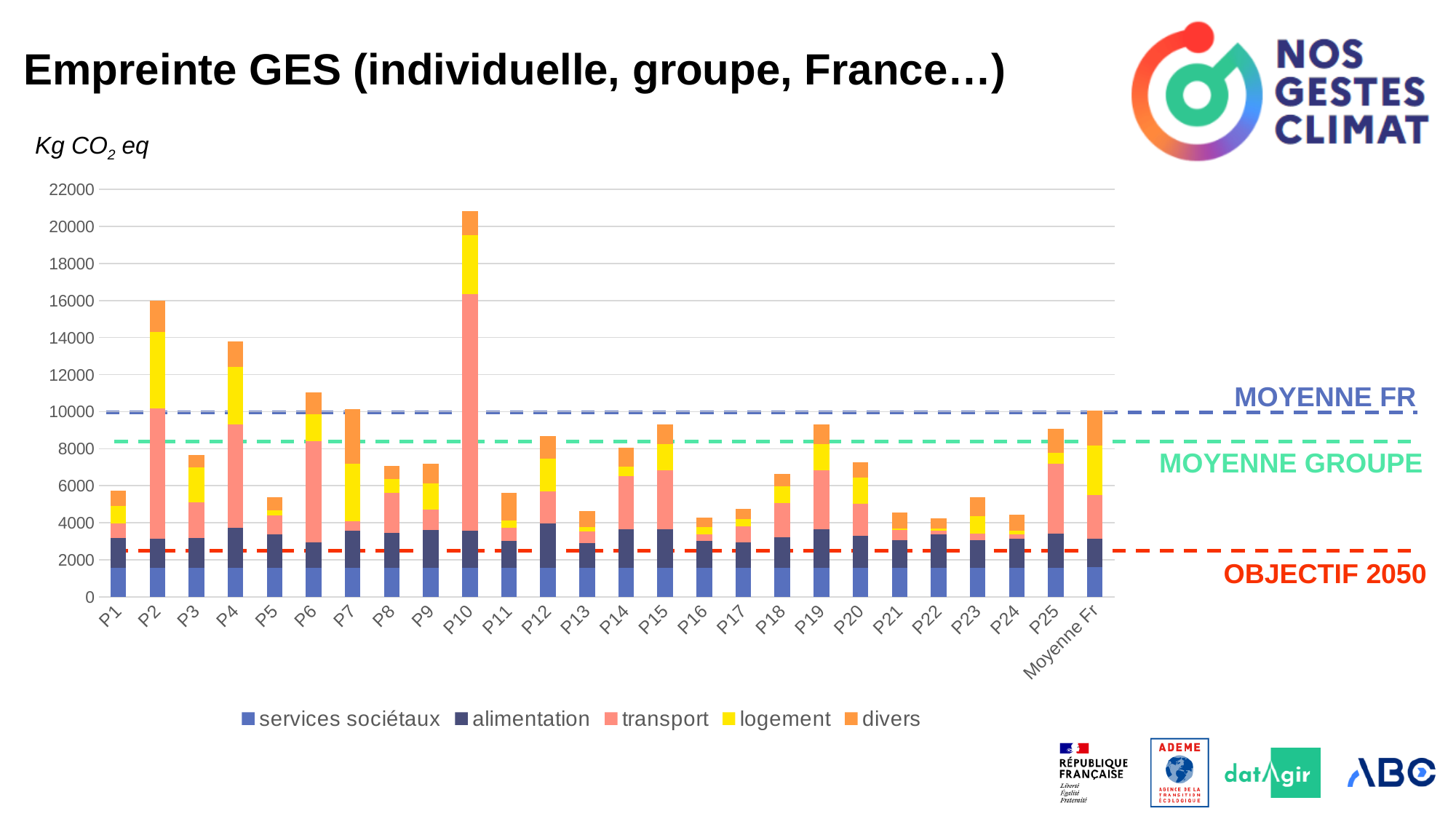
Is the total value for P4 greater or less than 12000? greater Which series is shown in yellow in the legend? logement Which category has the highest total bar? P10 Is the total value for P2 greater or less than 14000? greater How many series does the legend list? 5 What kind of chart is shown on the slide? Stacked bar chart What is the label of the red dashed horizontal line? OBJECTIF 2050 Which has the larger total bar, P12 or P13? P12 Is the total value for P1 greater or less than 6000? less How many bars (categories) are plotted along the x axis? 26 Which has the larger total bar, P2 or P4? P2